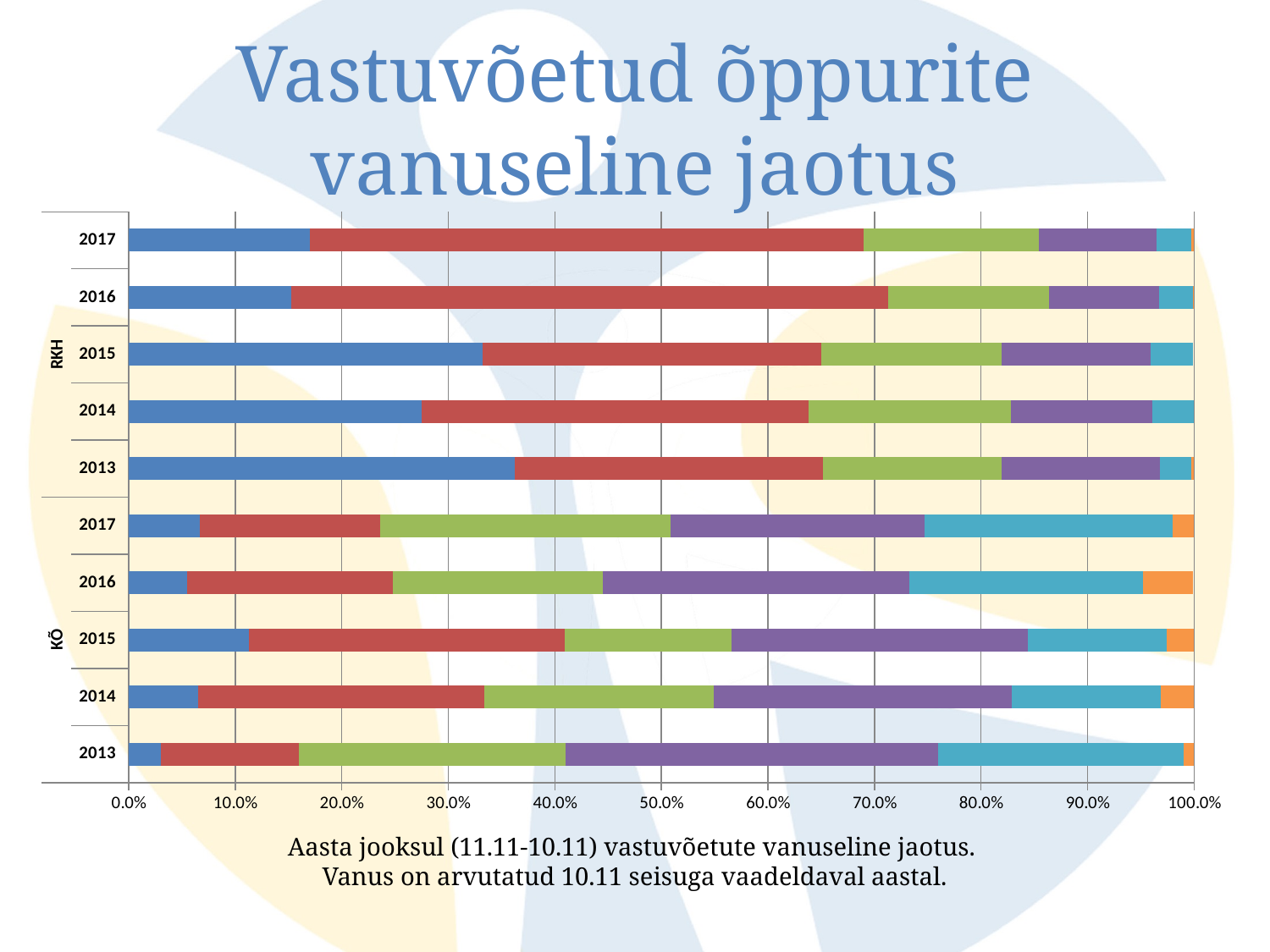
Among the KÕ bars, which year has the largest blue segment? 2015 What kind of chart is shown on the slide? Stacked horizontal bar chart Which bar has the larger blue segment, RKH 2015 or RKH 2016? RKH 2015 Is the blue segment of the RKH 2013 bar greater or less than 30%? greater Which bar has the larger green segment, KÕ 2017 or KÕ 2016? KÕ 2017 Does the red segment of the RKH 2017 bar end at a value greater or less than 60%? greater Is the blue segment of the KÕ 2013 bar greater or less than 10%? less How many bars are plotted in the chart? 10 What is the title of the chart on the slide? Vastuvõetud õppurite vanuseline jaotus What are the two group labels shown on the vertical axis of the chart? RKH and KÕ Which bar has the larger blue segment, KÕ 2015 or KÕ 2016? KÕ 2015 Among the KÕ bars, which year has the smallest blue segment? 2013